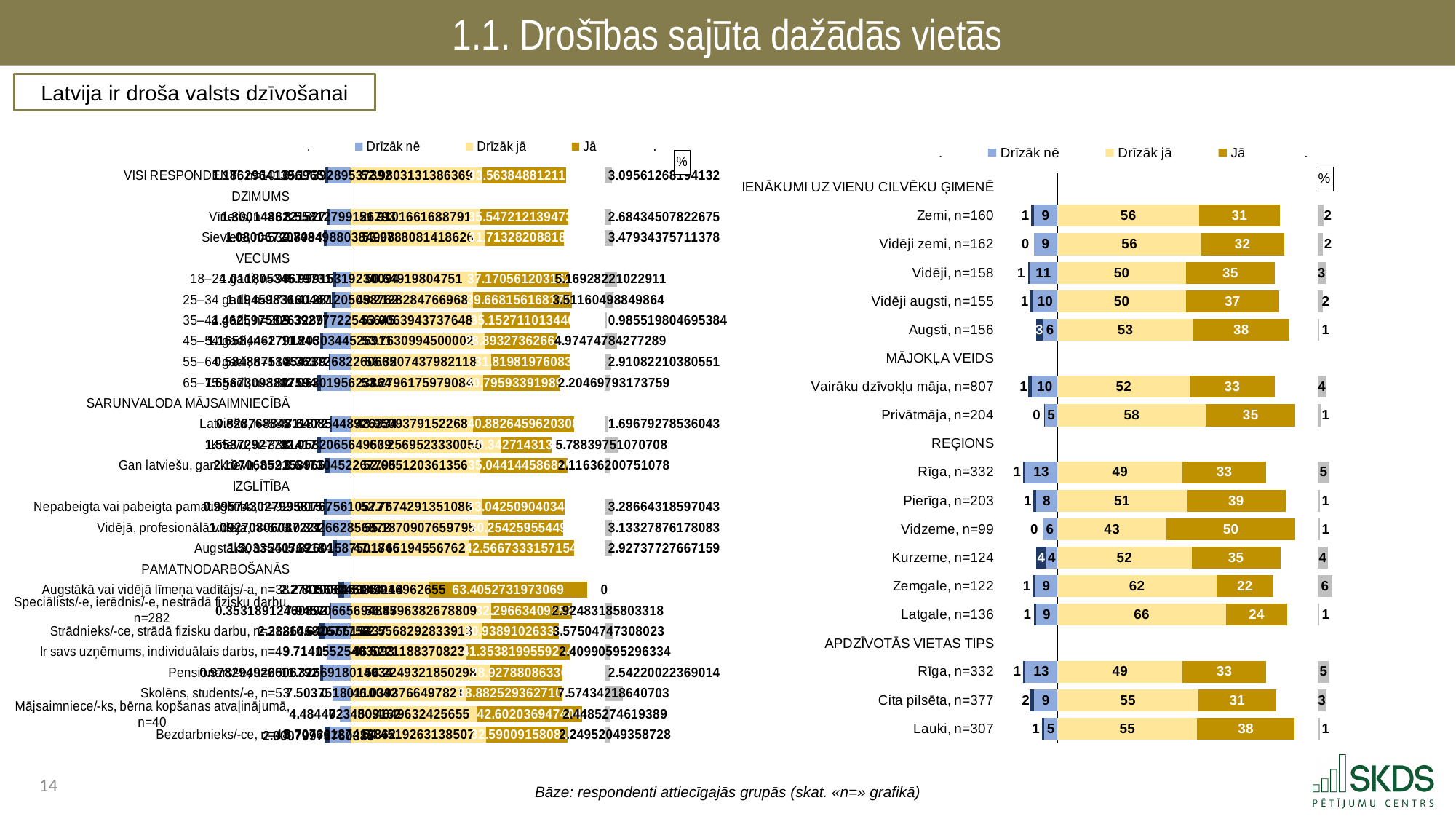
In the right-hand chart, what is the value of "Jā" for Lauki, n=307? 38 What kind of chart is the right-hand chart? Stacked horizontal bar chart In the right-hand chart, what is the value of "Drīzāk nē" for Rīga, n=332 under REĢIONS? 13 In the right-hand chart, what is the value of "Drīzāk jā" for Latgale, n=136? 66 In the right-hand chart, which has the larger "Drīzāk jā" value: Privātmāja, n=204 or Vairāku dzīvokļu māja, n=807? Privātmāja, n=204 In the right-hand chart, what is the difference between the "Jā" values for Augsti, n=156 and Zemi, n=160? 7 In the right-hand chart, which region under REĢIONS has the lowest "Jā" value? Zemgale, n=122 How many category bars are plotted in the right-hand chart? 16 How many series does the legend of the right-hand chart list? 3 In the right-hand chart, which income group under IENĀKUMI UZ VIENU CILVĒKU ĢIMENĒ has the highest "Jā" value? Augsti, n=156 In the right-hand chart, what is the value of "Jā" for Vidzeme, n=99? 50 In the right-hand chart, which region under REĢIONS has the highest "Jā" value? Vidzeme, n=99